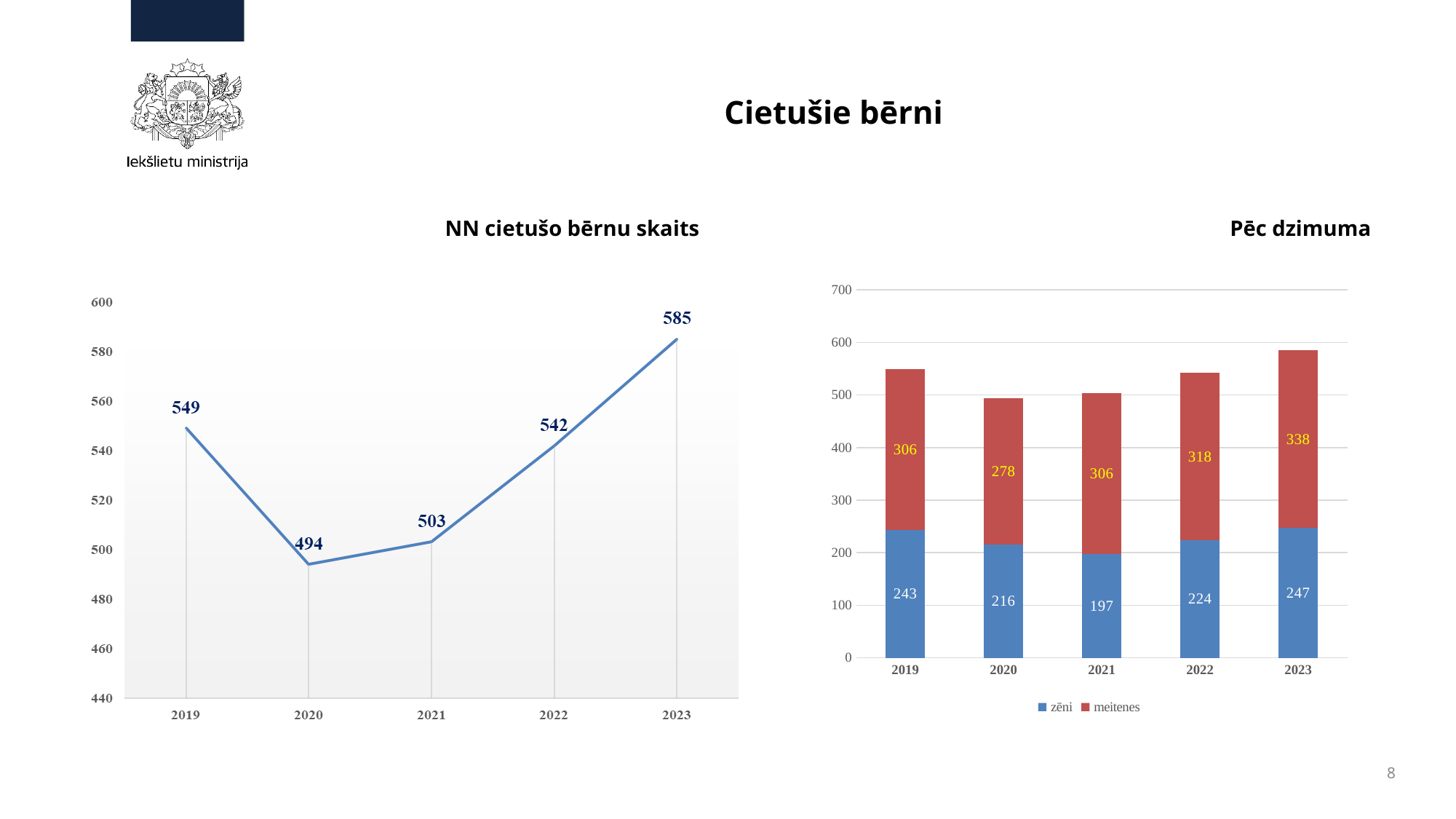
In the 'NN cietušo bērnu skaits' chart, do the values rise or fall from 2020 to 2023? rise In the 'Pēc dzimuma' chart, how many series does the legend list? 2 In the 'NN cietušo bērnu skaits' chart, what is the value for 2021? 503 In the 'Pēc dzimuma' chart, what is the total of the stacked bar for 2022? 542 In the 'Pēc dzimuma' chart, what is the value for meitenes in 2020? 278 In the 'NN cietušo bērnu skaits' chart, what is the difference between the values for 2023 and 2019? 36 In the 'NN cietušo bērnu skaits' chart, what kind of chart is shown? line chart In the 'NN cietušo bērnu skaits' chart, which year has the lowest value? 2020 In the 'Pēc dzimuma' chart, what is the value for zēni in 2021? 197 In the 'Pēc dzimuma' chart, how many years are shown on the x axis? 5 In the 'Pēc dzimuma' chart, which is larger in 2023, zēni or meitenes? meitenes In the 'NN cietušo bērnu skaits' chart, which year has the highest value? 2023